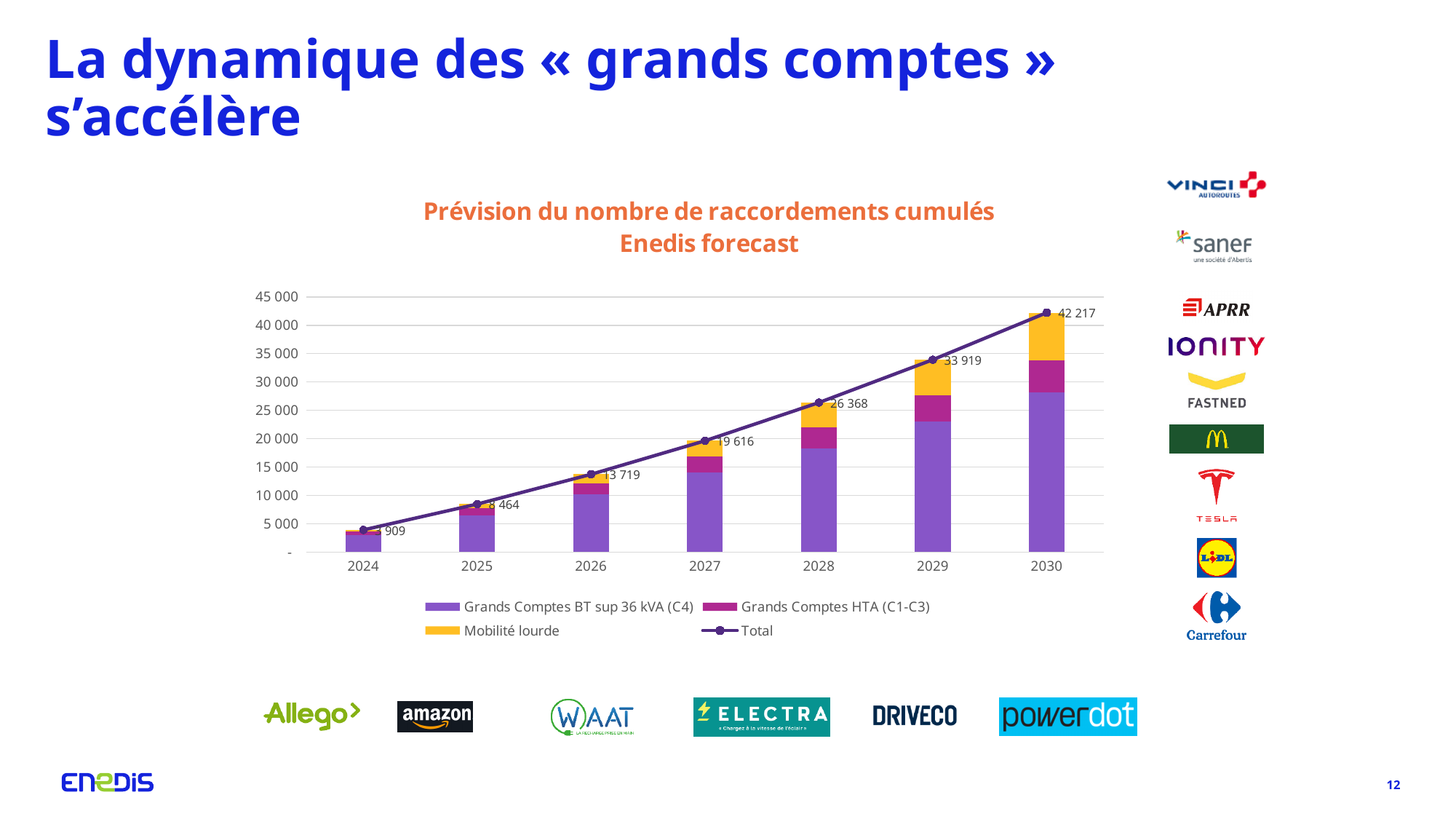
What is the Total value for 2030? 42 217 How many years are shown on the x axis? 7 What is the Total value for 2028? 26 368 What is the difference between the Total for 2030 and the Total for 2029? 8 298 What is the Total value for 2026? 13 719 Which year has the lowest Total? 2024 What is the Total value for 2027? 19 616 How many series does the legend list? 4 Is the value for Grands Comptes BT sup 36 kVA (C4) in 2030 greater or less than 25 000? greater Which year has the highest Total? 2030 What kind of chart is shown on the slide? stacked bar and line chart Does the Total rise or fall from 2024 to 2030? rise